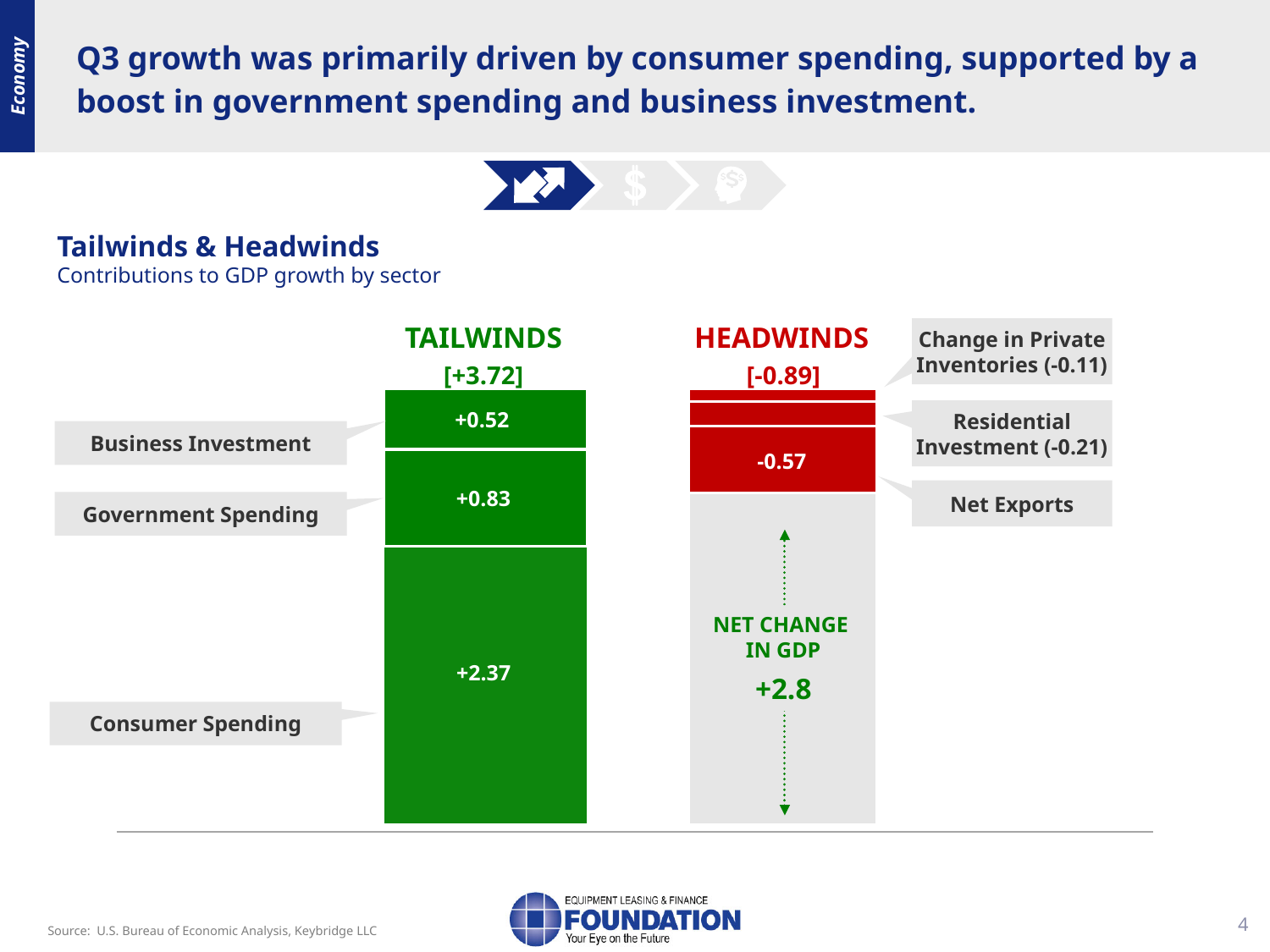
Which headwind sector has the smallest negative contribution? Change in Private Inventories What is the difference between the Consumer Spending and Government Spending contributions? 1.54 Which tailwind sector contributes the most to GDP growth? Consumer Spending What is the total of the Tailwinds bar? +3.72 What is the net change in GDP shown on the chart? +2.8 What is the contribution of Government Spending to GDP growth? +0.83 Which is larger in magnitude: the Net Exports contribution or the Residential Investment contribution? Net Exports What is the contribution of Business Investment to GDP growth? +0.52 What is the contribution of Consumer Spending to GDP growth in the Tailwinds & Headwinds chart? +2.37 What is the contribution of Net Exports to GDP growth? -0.57 What is the contribution of Residential Investment to GDP growth? -0.21 What is the total of the Headwinds bar? -0.89